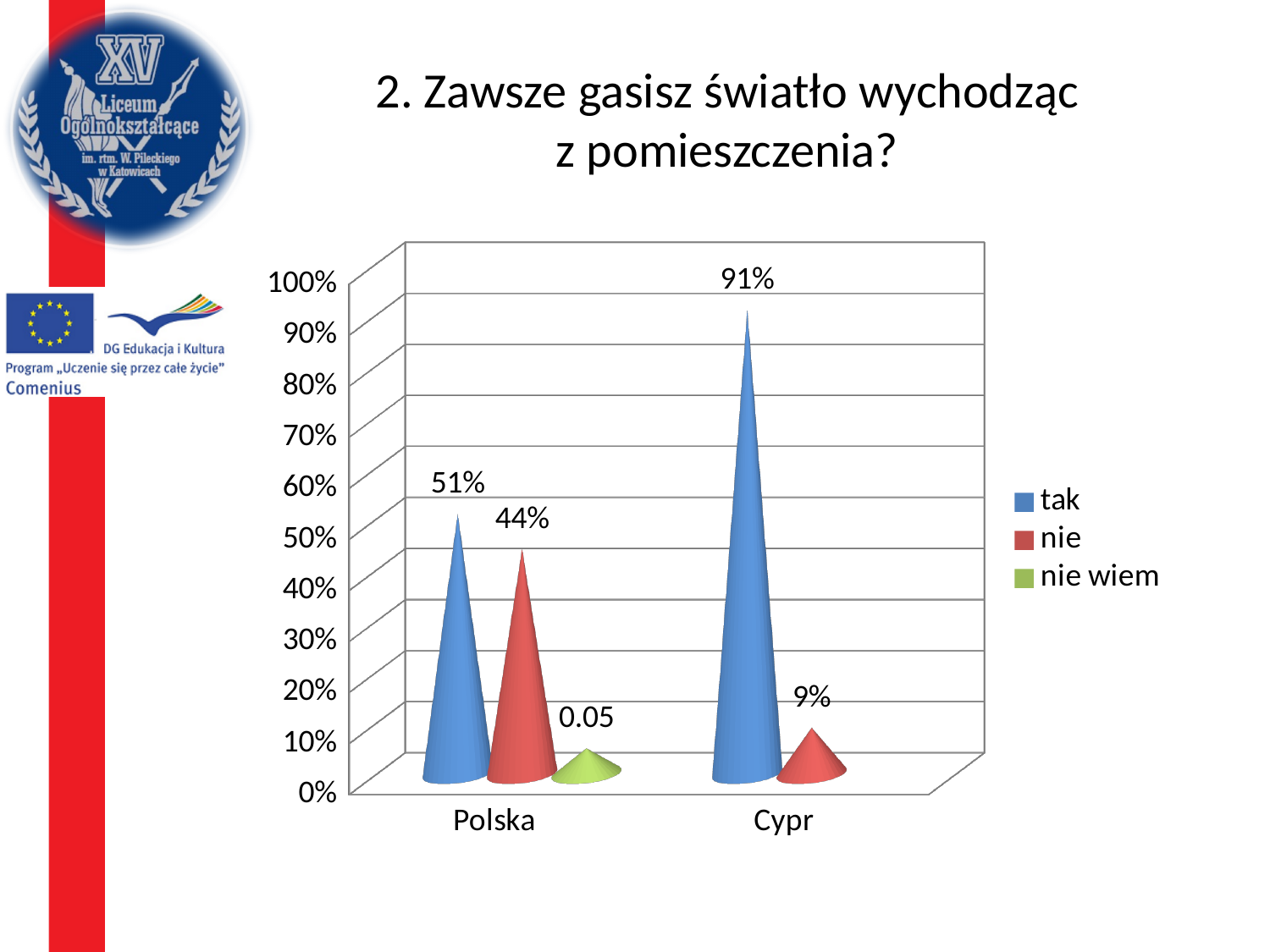
What is the value for "tak" for Polska? 51% What is the value for "nie" for Cypr? 9% What is the title of the chart? 2. Zawsze gasisz światło wychodząc z pomieszczenia? What data label is shown for "nie wiem" for Polska? 0.05 How many series does the legend list? 3 What is the value for "tak" for Cypr? 91% What is the value for "nie" for Polska? 44% Which category has the lowest value for "nie"? Cypr Which category has the highest value for "tak"? Cypr Which is larger for Polska: "tak" or "nie"? tak What is the difference between the "tak" values for Cypr and Polska? 40% How many categories are shown on the x axis? 2